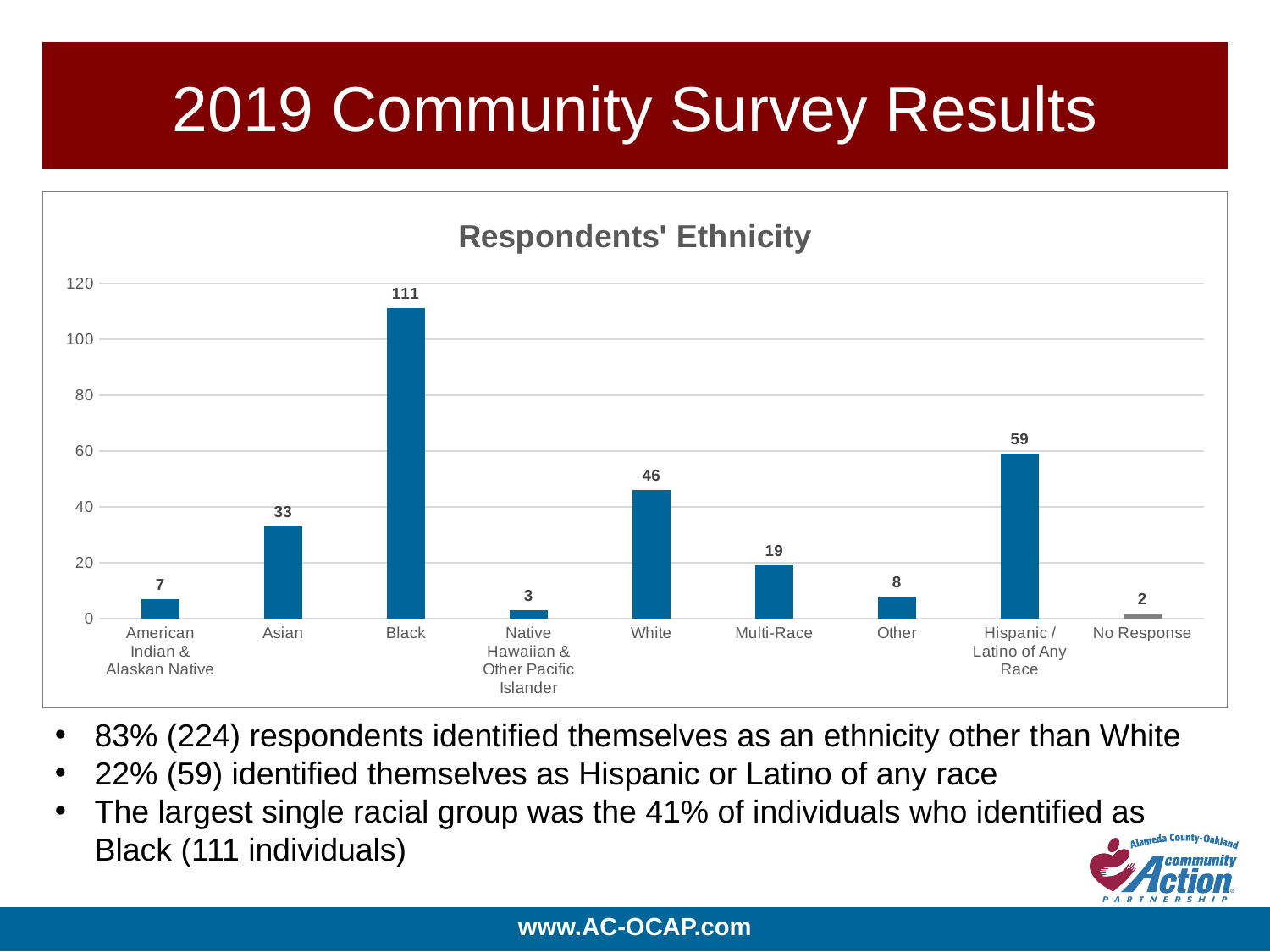
Which category has the lowest value? No Response How many categories are shown on the x axis? 9 What is the value for Native Hawaiian & Other Pacific Islander? 3 Which is larger, the value for White or the value for Hispanic / Latino of Any Race? Hispanic / Latino of Any Race How many respondents identified as Hispanic / Latino of Any Race? 59 What is the title of the chart? Respondents' Ethnicity Which category has the highest value? Black What is the difference between the values for Asian and Multi-Race? 14 What kind of chart is shown on the slide? bar chart Is the value for Asian greater or less than 40? less What is the difference between the values for Black and White? 65 What is the value for Black in the Respondents' Ethnicity chart? 111